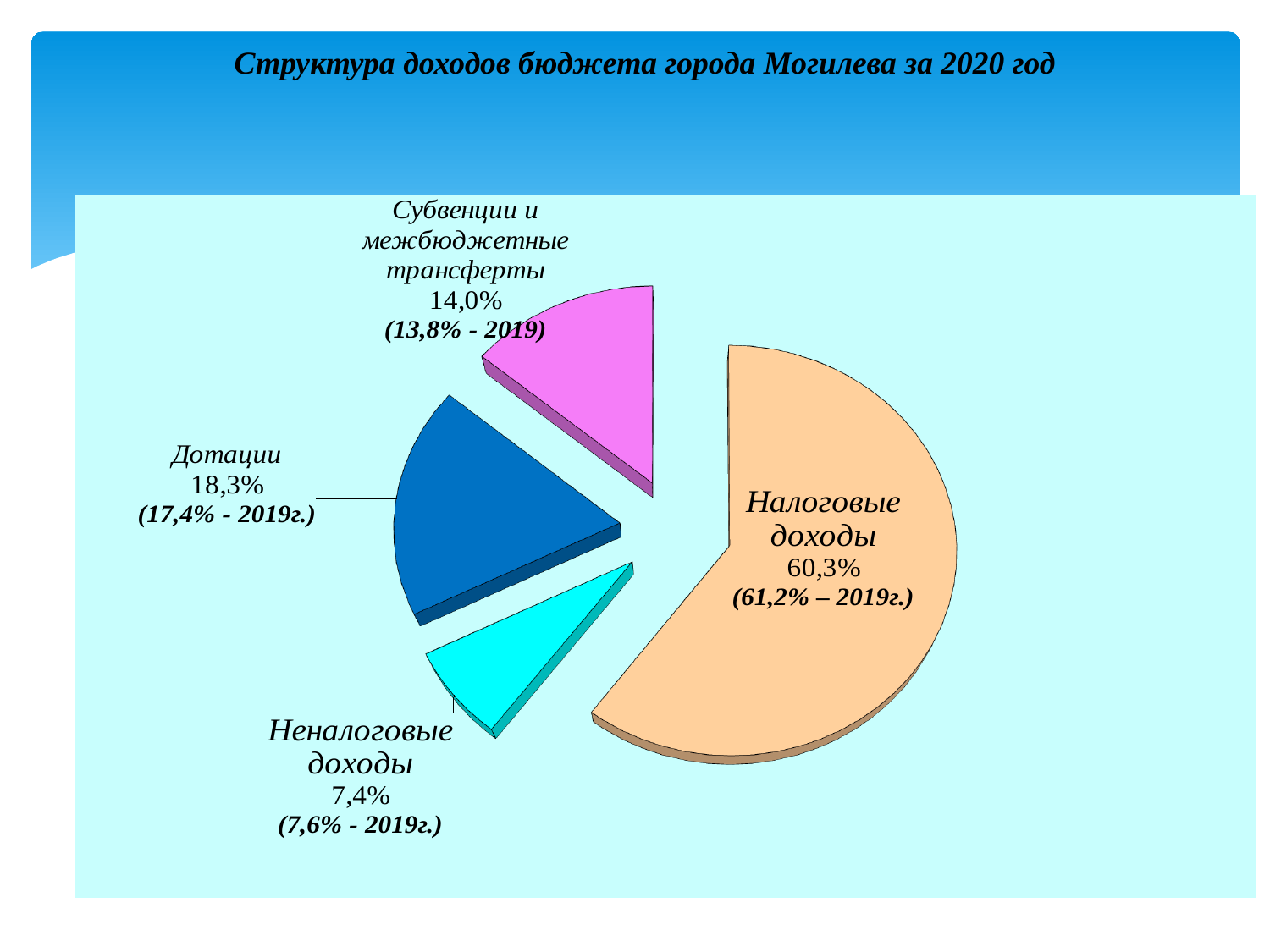
What is the share of Налоговые доходы in 2020? 60,3% What is the difference between the 2020 shares of Дотации and Неналоговые доходы? 10,9% What is the share of Дотации in 2020? 18,3% Which is larger: the share of Дотации or the share of Субвенции и межбюджетные трансферты? Дотации What was the share of Дотации in 2019, as shown in parentheses? 17,4% What is the share of Неналоговые доходы in 2020? 7,4% How many slices does the pie chart have? 4 Which category has the smallest share of the pie? Неналоговые доходы What was the share of Налоговые доходы in 2019, as shown in parentheses? 61,2% What type of chart is shown on the slide? pie chart What is the share of Субвенции и межбюджетные трансферты in 2020? 14,0% Which category has the largest share of the pie? Налоговые доходы